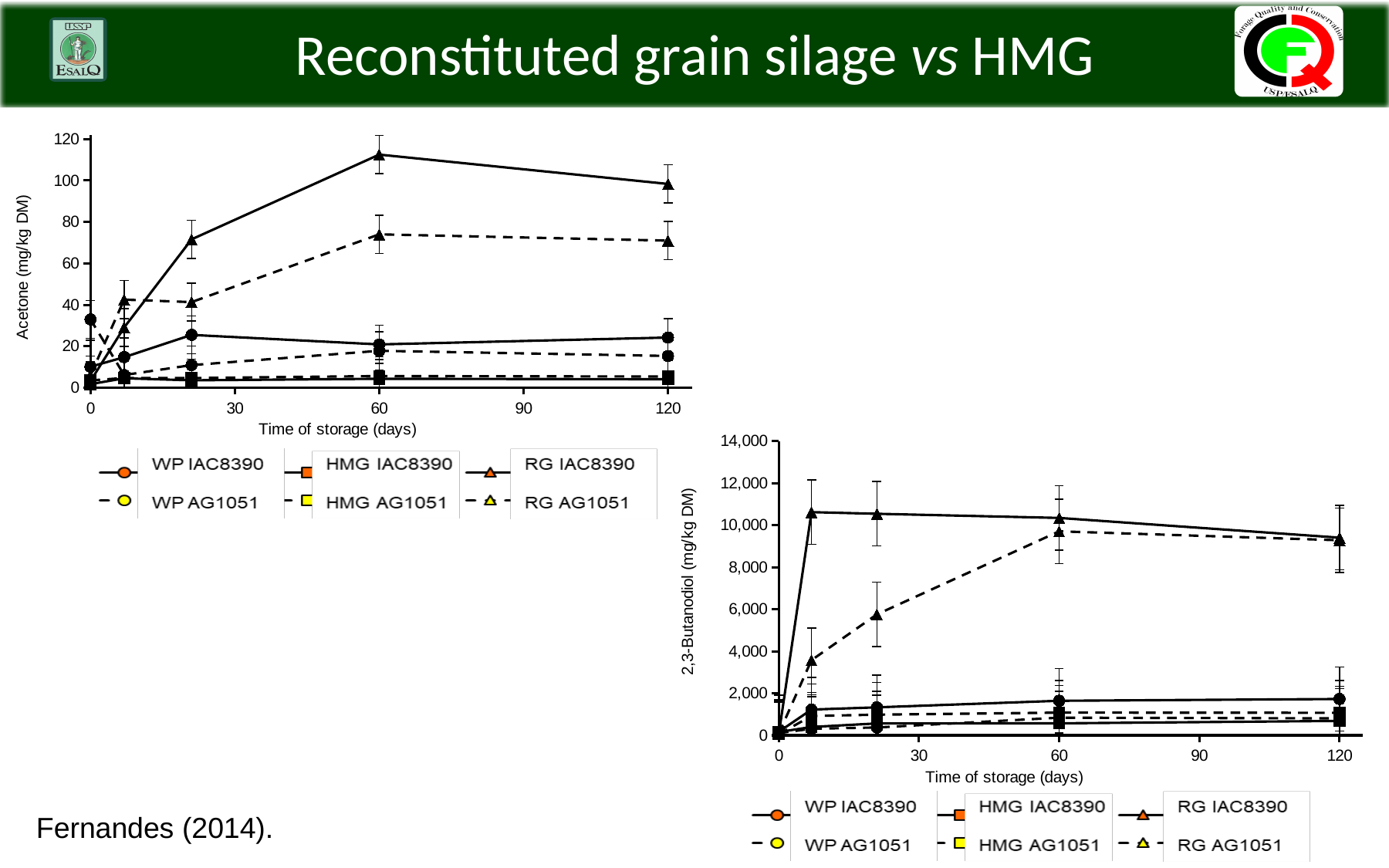
In the Acetone chart, is the value for RG AG1051 at 60 days greater or less than 60? greater What is the y-axis title of the chart on the bottom right of the slide? 2,3-Butanodiol (mg/kg DM) In the Acetone chart, does the RG IAC8390 series rise or fall between 0 and 60 days of storage? rise In the 2,3-Butanodiol chart, is the value for WP IAC8390 at 120 days greater or less than 4,000? less In the Acetone chart, is the value for RG IAC8390 at 60 days greater or less than 100? greater How many series does the legend of the 2,3-Butanodiol chart list? 6 What kind of chart is the Acetone chart on the top left of the slide? line chart In the 2,3-Butanodiol chart, which is larger at 60 days: RG IAC8390 or WP IAC8390? RG IAC8390 In the Acetone chart, which series has the highest value at 60 days of storage? RG IAC8390 What is the x-axis title of the Acetone chart? Time of storage (days)